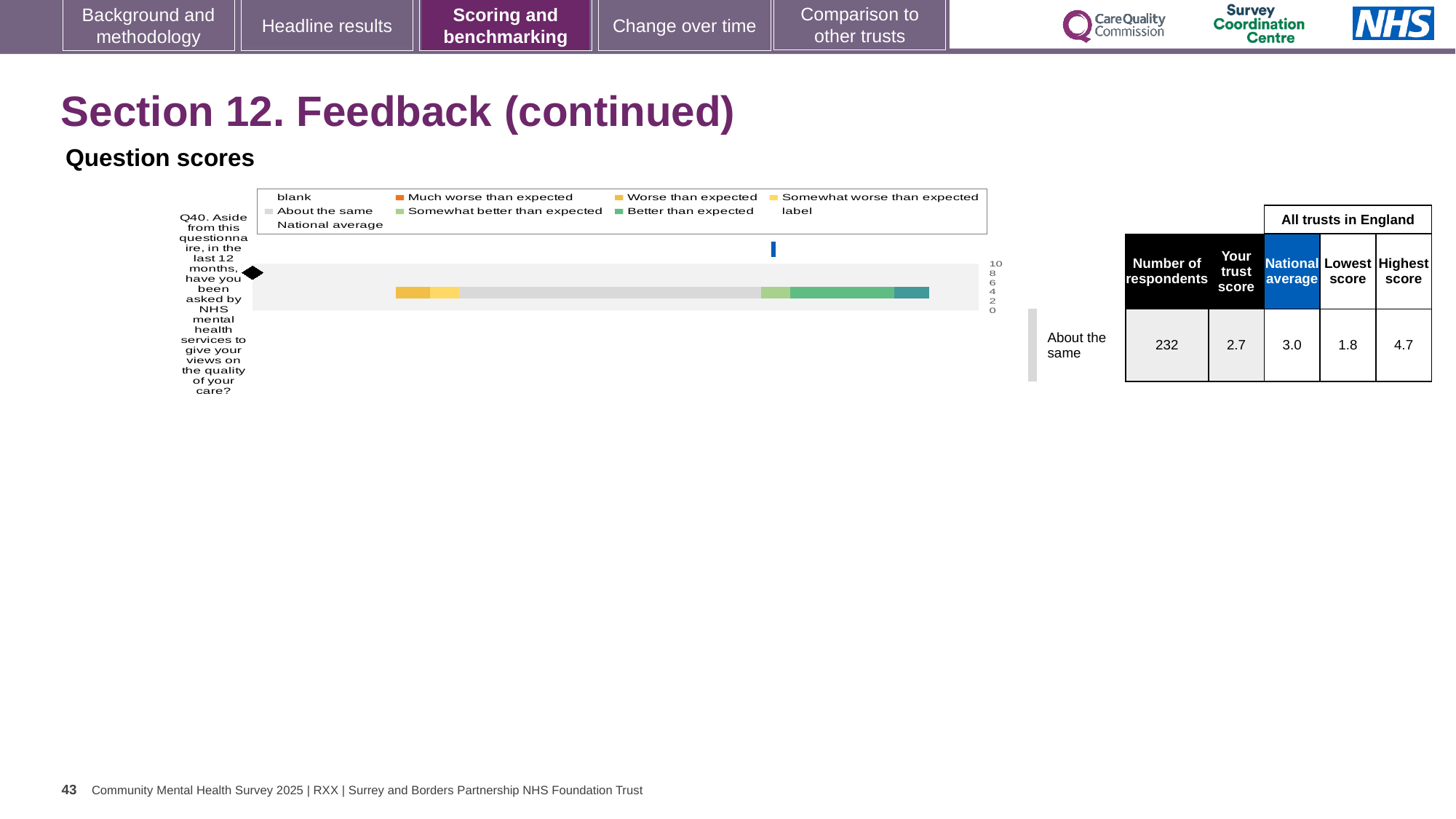
Is the trust's score for Q40 higher or lower than the national average? lower What is the national average score for Q40? 3.0 How many respondents answered Q40? 232 What is the lowest score among all trusts in England for Q40? 1.8 What kind of chart is shown on the slide? bar chart Which question number is plotted in the chart? Q40 What is the difference between the highest and lowest scores for Q40? 2.9 How many questions are plotted in the chart? 1 What is the highest score among all trusts in England for Q40? 4.7 What is the trust's score for Q40? 2.7 What benchmark category is shown for Q40? About the same Which legend entry is shown in orange? Much worse than expected